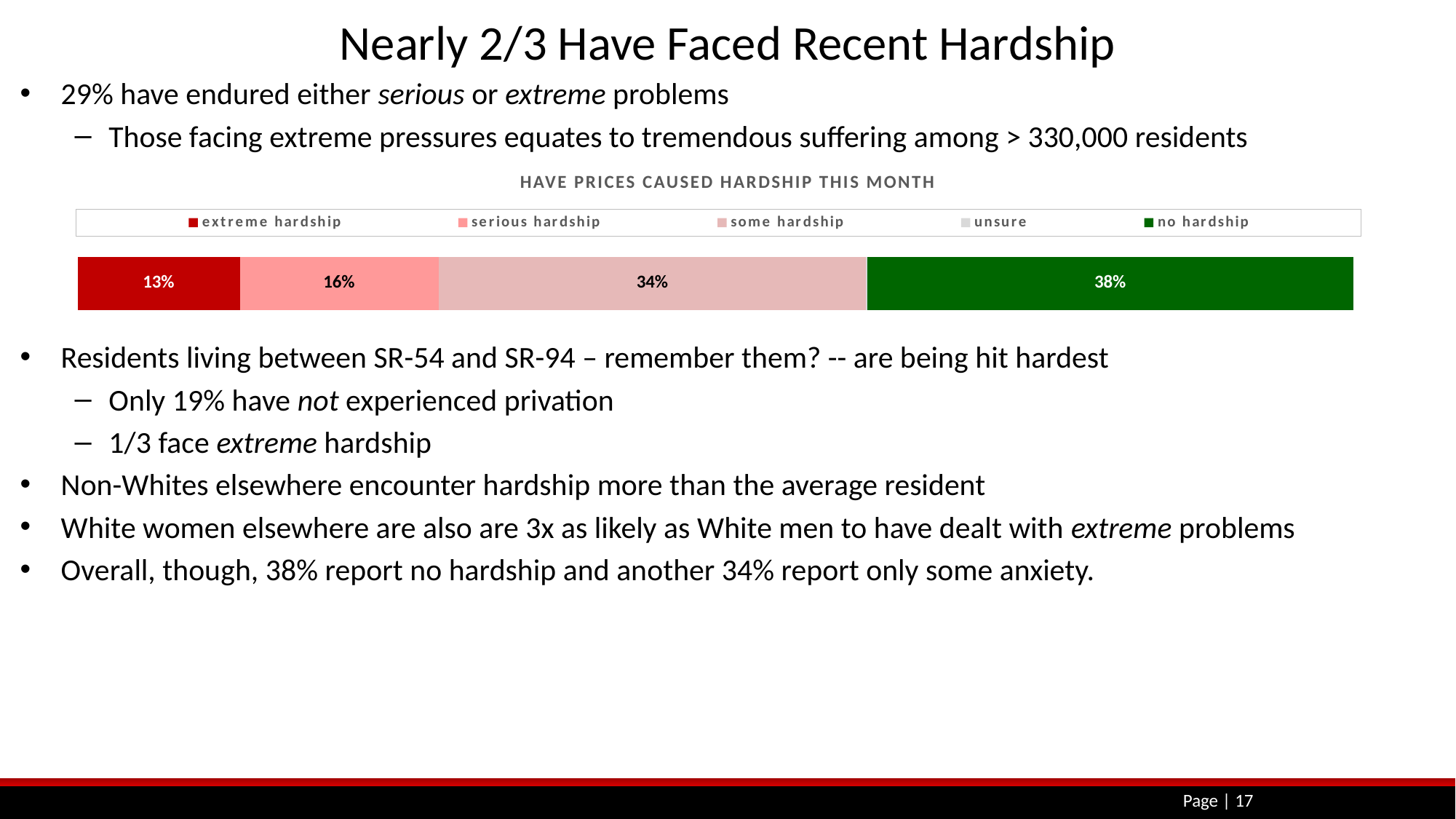
How much larger is the some hardship share than the serious hardship share? 18% What percentage of respondents reported some hardship? 34% What percentage of respondents reported extreme hardship? 13% What percentage of respondents reported no hardship? 38% What is the difference between the no hardship share and the extreme hardship share? 25% Of the segments with printed values, which response category has the smallest share? extreme hardship What is the title of the chart? HAVE PRICES CAUSED HARDSHIP THIS MONTH Which is larger, the serious hardship share or the extreme hardship share? serious hardship Which response category has the largest share in the bar? no hardship What kind of chart is shown on the slide? bar chart How many series does the chart legend list? 5 What percentage of respondents reported serious hardship? 16%